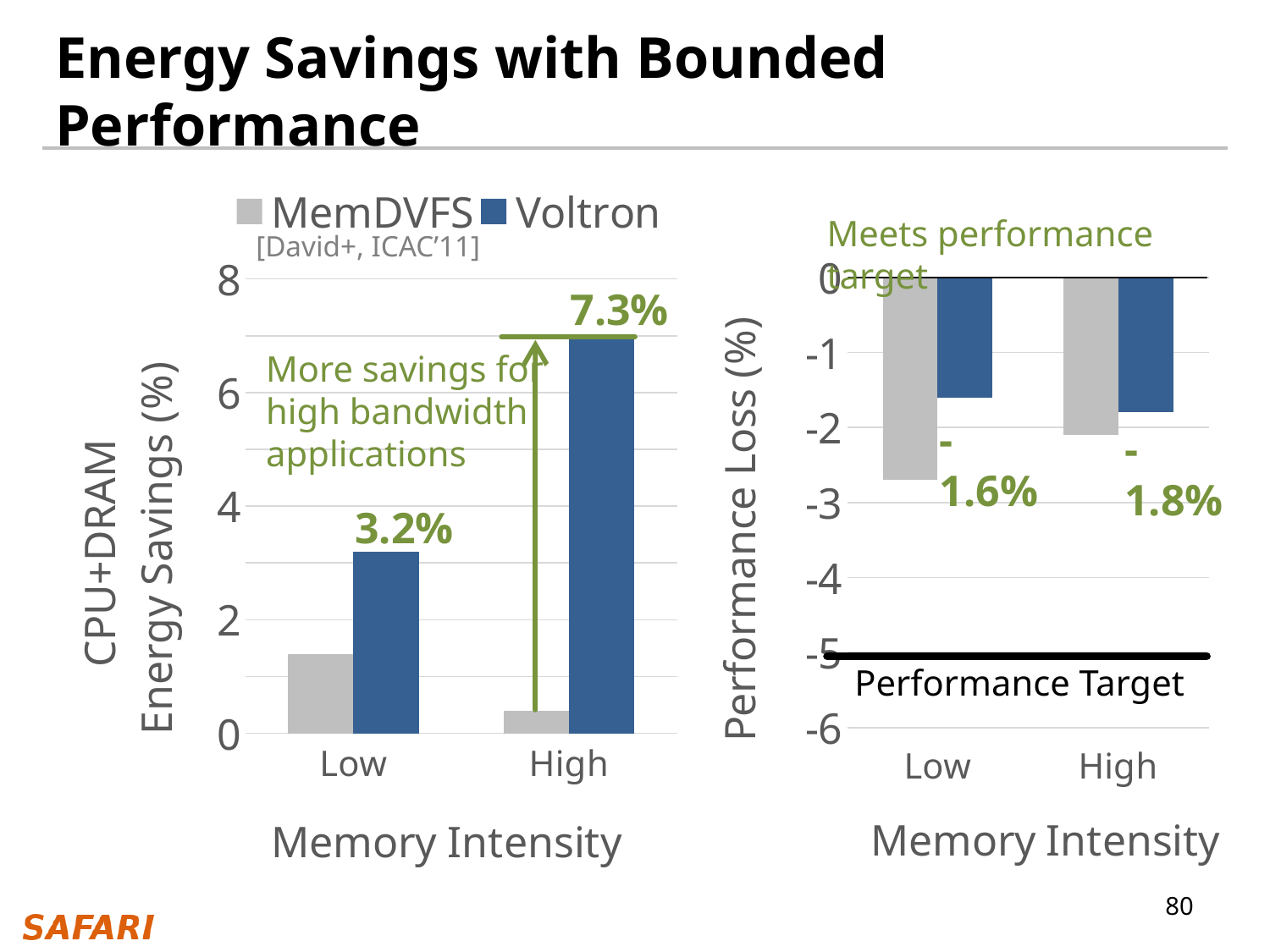
In the left chart (CPU+DRAM Energy Savings), which series has the higher energy savings at High memory intensity, MemDVFS or Voltron? Voltron In the left chart (CPU+DRAM Energy Savings), what is the difference between Voltron's energy savings at High and Low memory intensity? 4.1% In the right chart (Performance Loss), is the MemDVFS value at Low memory intensity greater or less than -2? less How many series does the legend list? 2 In the right chart (Performance Loss), what is the performance loss for Voltron at High memory intensity? -1.8% How many memory intensity categories are shown on the x axis of the left chart? 2 In the left chart (CPU+DRAM Energy Savings), what is the energy savings value for Voltron at High memory intensity? 7.3% What kind of chart is the right chart (Performance Loss)? bar chart In the left chart (CPU+DRAM Energy Savings), is the MemDVFS value at Low memory intensity greater or less than 2? less In the left chart (CPU+DRAM Energy Savings), what is the energy savings value for Voltron at Low memory intensity? 3.2% In the right chart (Performance Loss), what is the performance loss for Voltron at Low memory intensity? -1.6% In the right chart (Performance Loss), what value does the Performance Target line sit at? -5